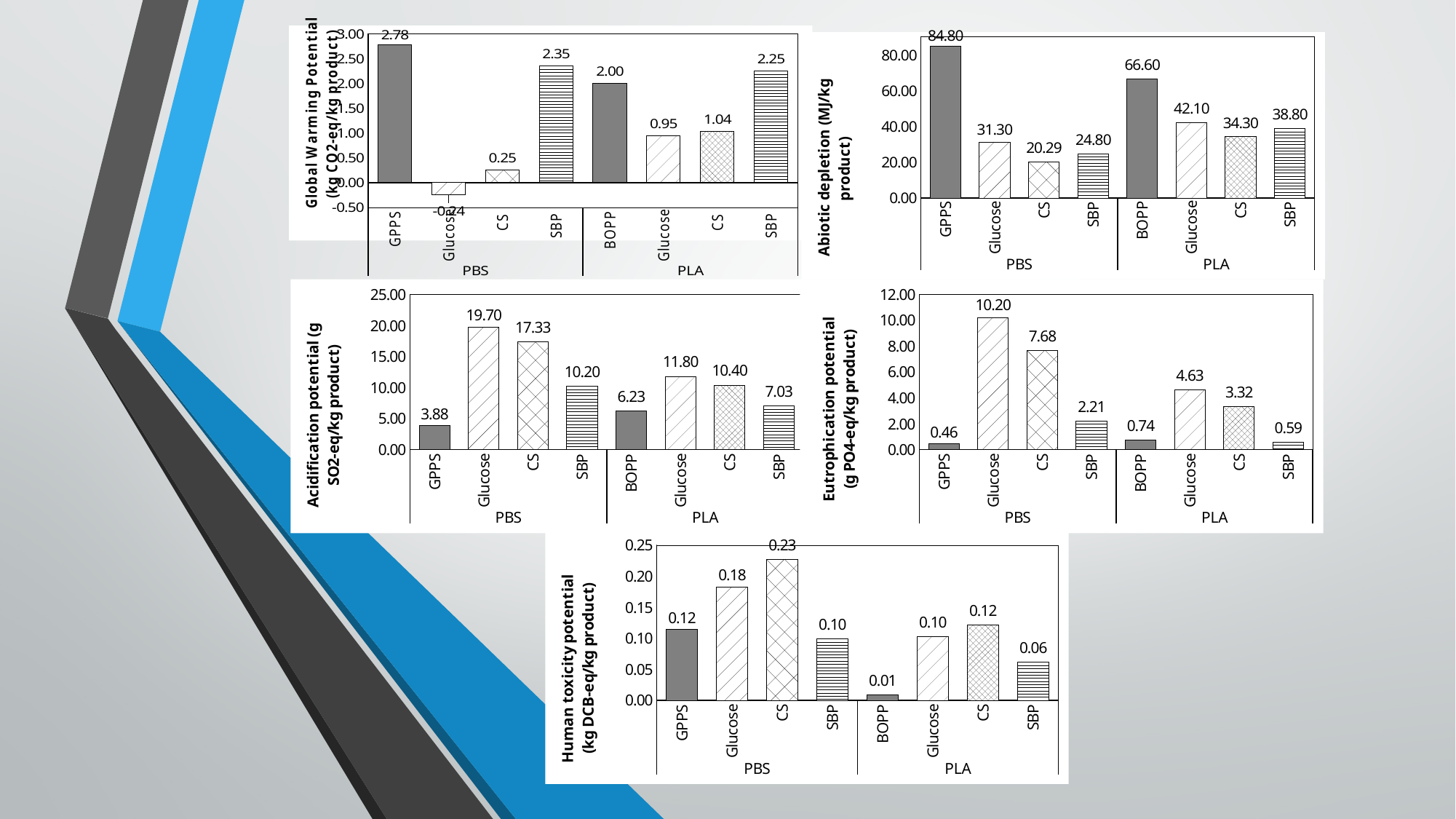
In the Abiotic depletion chart, what is the value for CS under PLA? 34.30 In the Global Warming Potential chart, what is the value for Glucose under PBS? -0.24 In the Eutrophication potential chart, what is the value for Glucose under PBS? 10.20 In the Abiotic depletion chart, which bar is the highest? GPPS (PBS) In the Eutrophication potential chart, what is the difference between CS under PBS and CS under PLA? 4.36 In the Acidification potential chart, which is larger: Glucose under PBS or Glucose under PLA? Glucose under PBS In the Abiotic depletion chart, what is the difference between GPPS under PBS and BOPP under PLA? 18.20 In the Human toxicity potential chart, what is the value for BOPP under PLA? 0.01 In the Acidification potential chart, which bar is the lowest? GPPS (PBS) In the Global Warming Potential chart, what is the value for GPPS under PBS? 2.78 What type of chart is the Acidification potential chart? Bar chart How many bars are plotted in the Human toxicity potential chart? 8